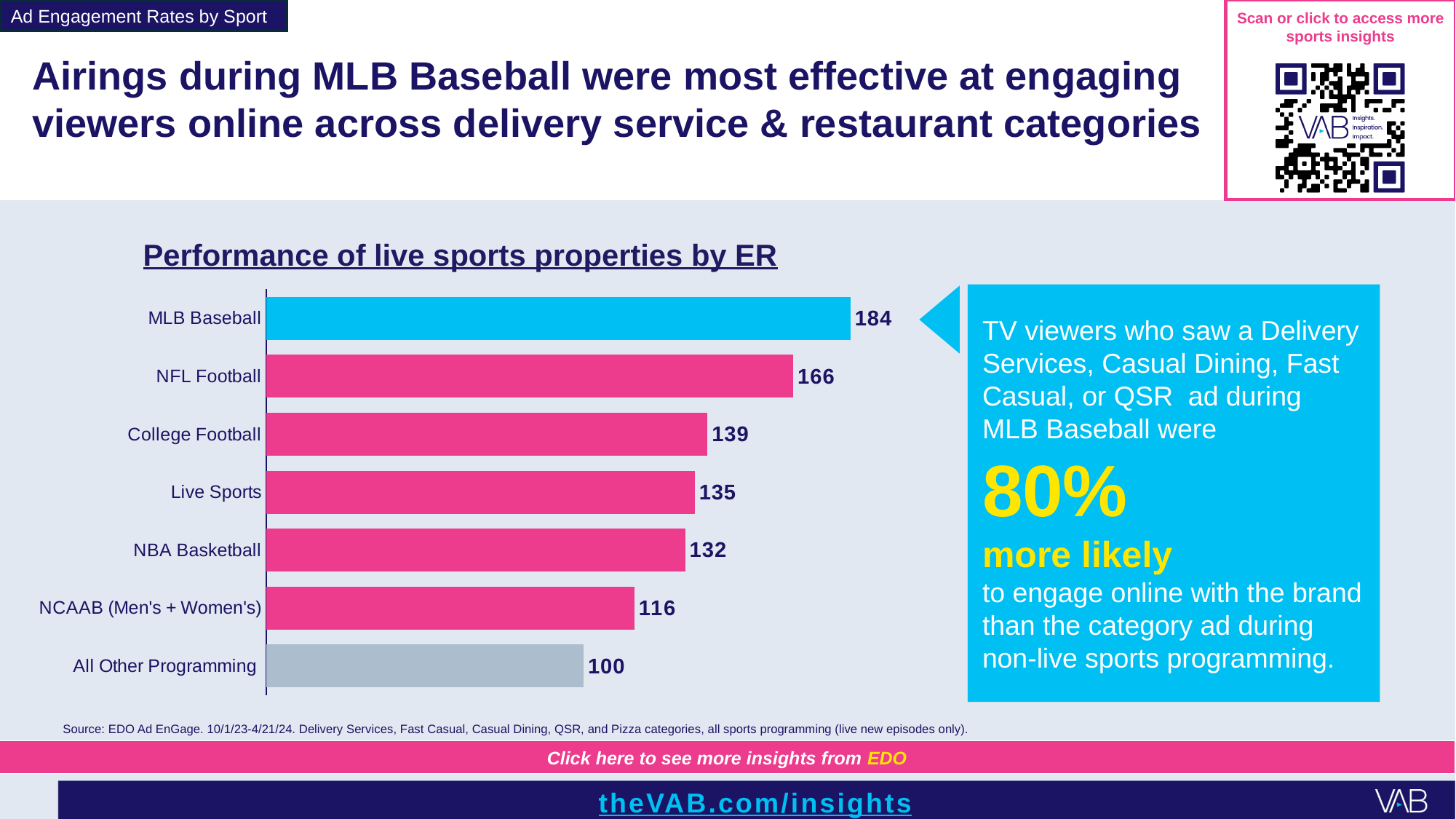
What is the difference between the values for College Football and NBA Basketball? 7 How many categories are shown in the chart? 7 What is the value for NCAAB (Men's + Women's)? 116 What is the title of the chart? Performance of live sports properties by ER What is the value for NFL Football? 166 Which category has the lowest value? All Other Programming What is the value for All Other Programming? 100 Which is larger, the value for Live Sports or the value for NBA Basketball? Live Sports What kind of chart is shown on the slide? Bar chart Which category has the highest value? MLB Baseball What is the value for MLB Baseball? 184 What is the difference between the values for MLB Baseball and NFL Football? 18